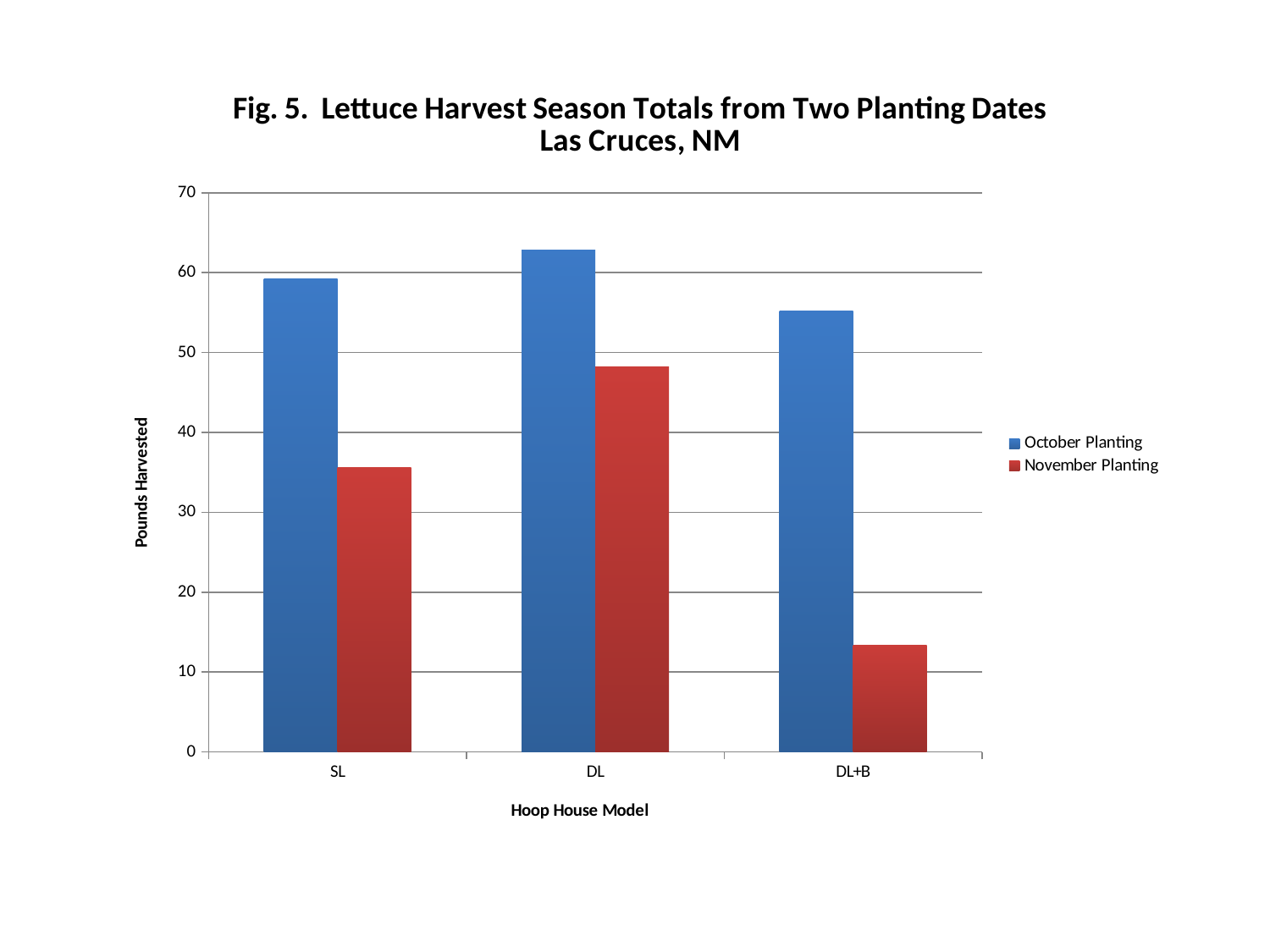
Is the November Planting value for SL greater or less than 40? less Which hoop house model has the highest November Planting harvest? DL Is the November Planting value for DL+B greater or less than 20? less What is the label on the x axis? Hoop House Model What is the label on the y axis? Pounds Harvested Is the October Planting value for DL greater or less than 60? greater What kind of chart is shown on the slide? bar chart Which hoop house model has the lowest November Planting harvest? DL+B For DL+B, which is larger: the October Planting or the November Planting harvest? October Planting How many hoop house models are shown on the x axis? 3 How many series does the legend list? 2 Which hoop house model has the highest October Planting harvest? DL